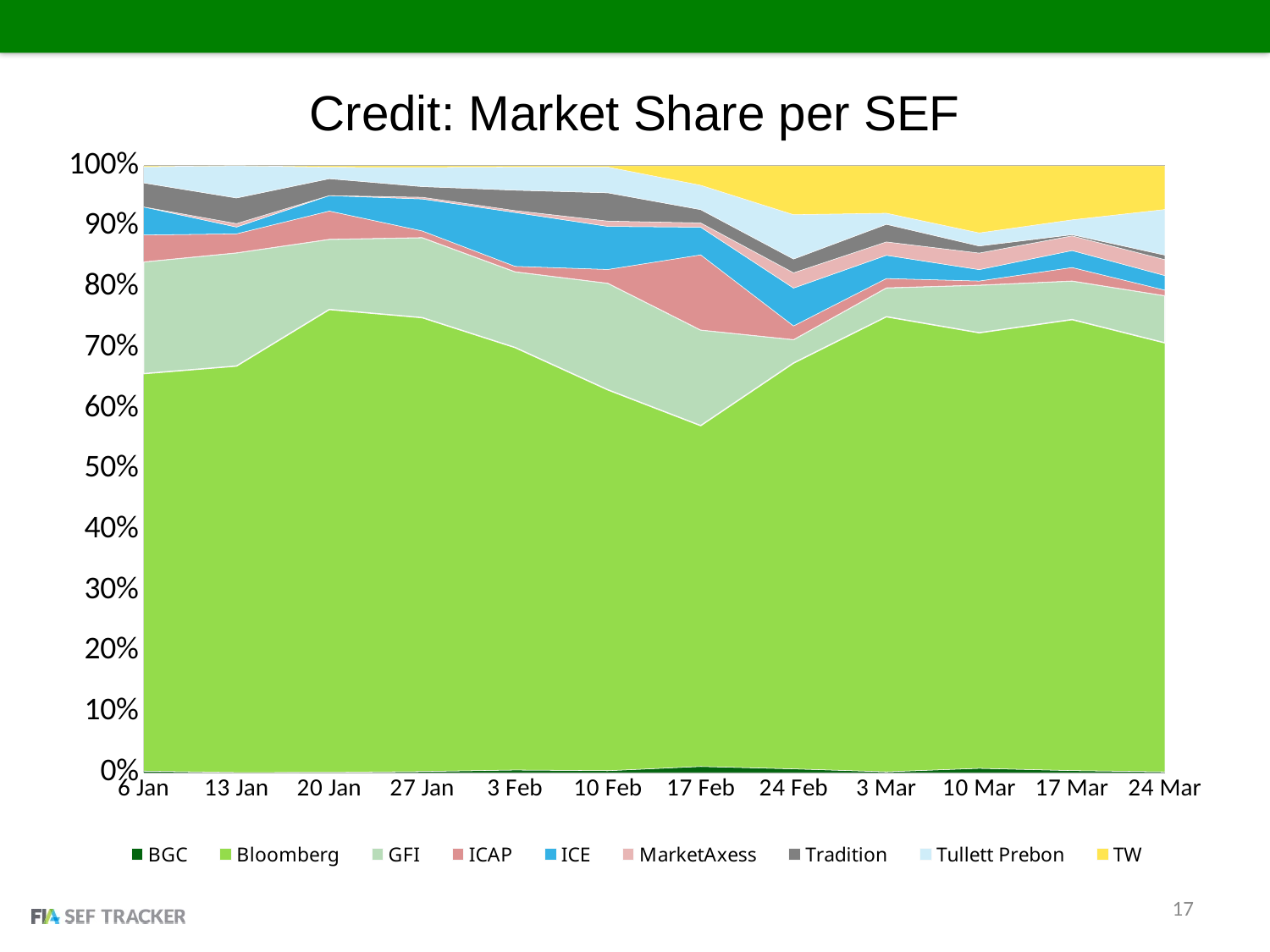
How many dates are shown along the x axis? 12 Is Bloomberg's market share on 17 Feb greater or less than 60%? less What kind of chart is shown on the slide? Stacked area chart What is the title of the chart? Credit: Market Share per SEF Is Bloomberg's market share on 24 Mar greater or less than 60%? greater Is Bloomberg's market share on 20 Jan greater or less than 70%? greater How many series does the legend list? 9 Is Bloomberg's market share larger on 20 Jan or on 17 Feb? 20 Jan Does Bloomberg's market share rise or fall from 20 Jan to 17 Feb? Fall Which colour represents TW in the chart? Yellow On which date is Bloomberg's market share at its lowest? 17 Feb Which SEF has the largest market share across the chart? Bloomberg